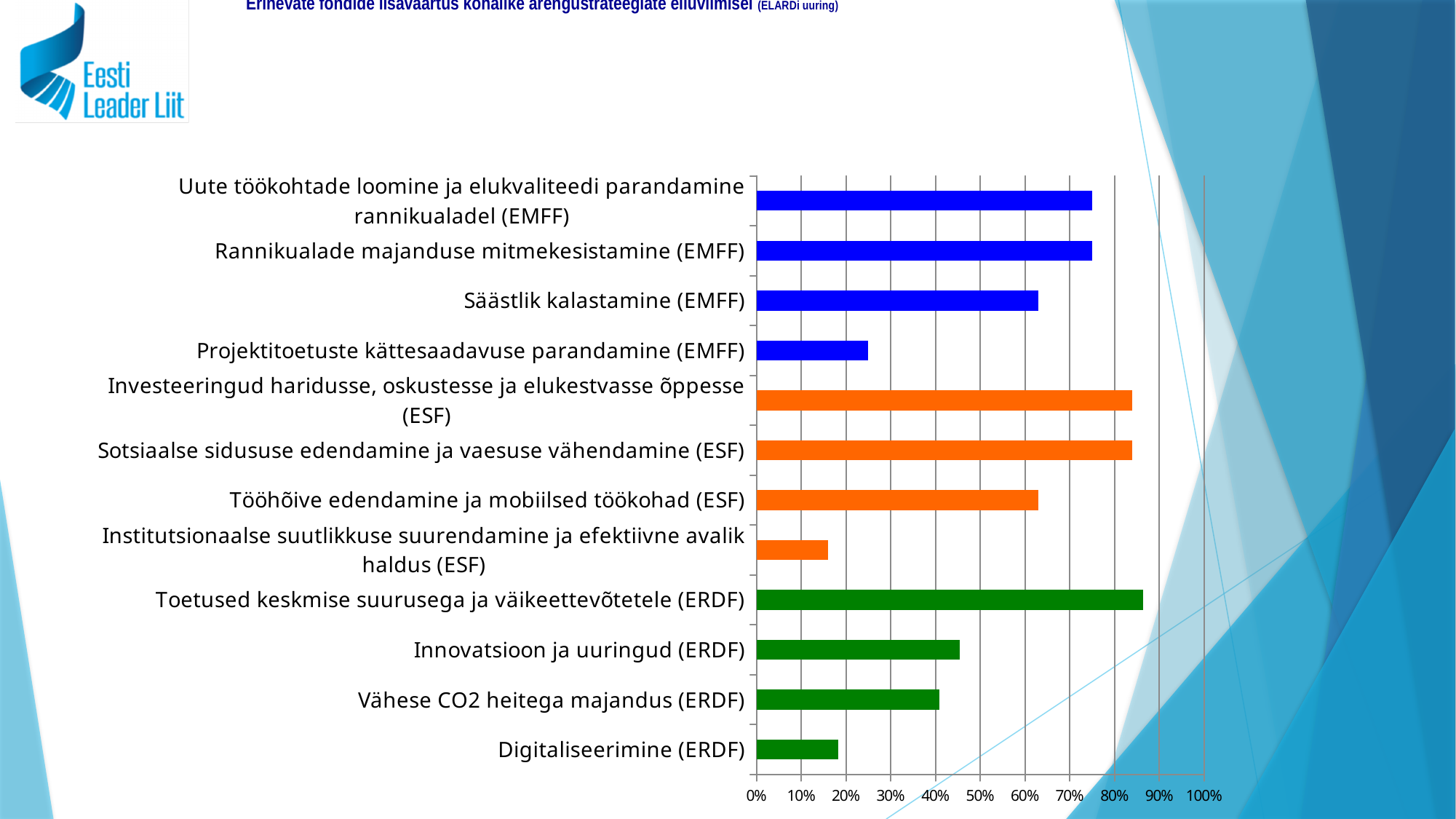
Which is larger: the value for Innovatsioon ja uuringud (ERDF) or the value for Digitaliseerimine (ERDF)? Innovatsioon ja uuringud (ERDF) Is the value for Projektitoetuste kättesaadavuse parandamine (EMFF) greater or less than 30%? less Is the value for Digitaliseerimine (ERDF) greater or less than 20%? less Is the value for Säästlik kalastamine (EMFF) greater or less than 60%? greater What colour are the bars for the ERDF categories? green How many categories are plotted in the chart? 12 What is the highest value shown on the x axis? 100% Which is larger: the value for Säästlik kalastamine (EMFF) or the value for Projektitoetuste kättesaadavuse parandamine (EMFF)? Säästlik kalastamine (EMFF) What kind of chart is shown on the slide? bar chart